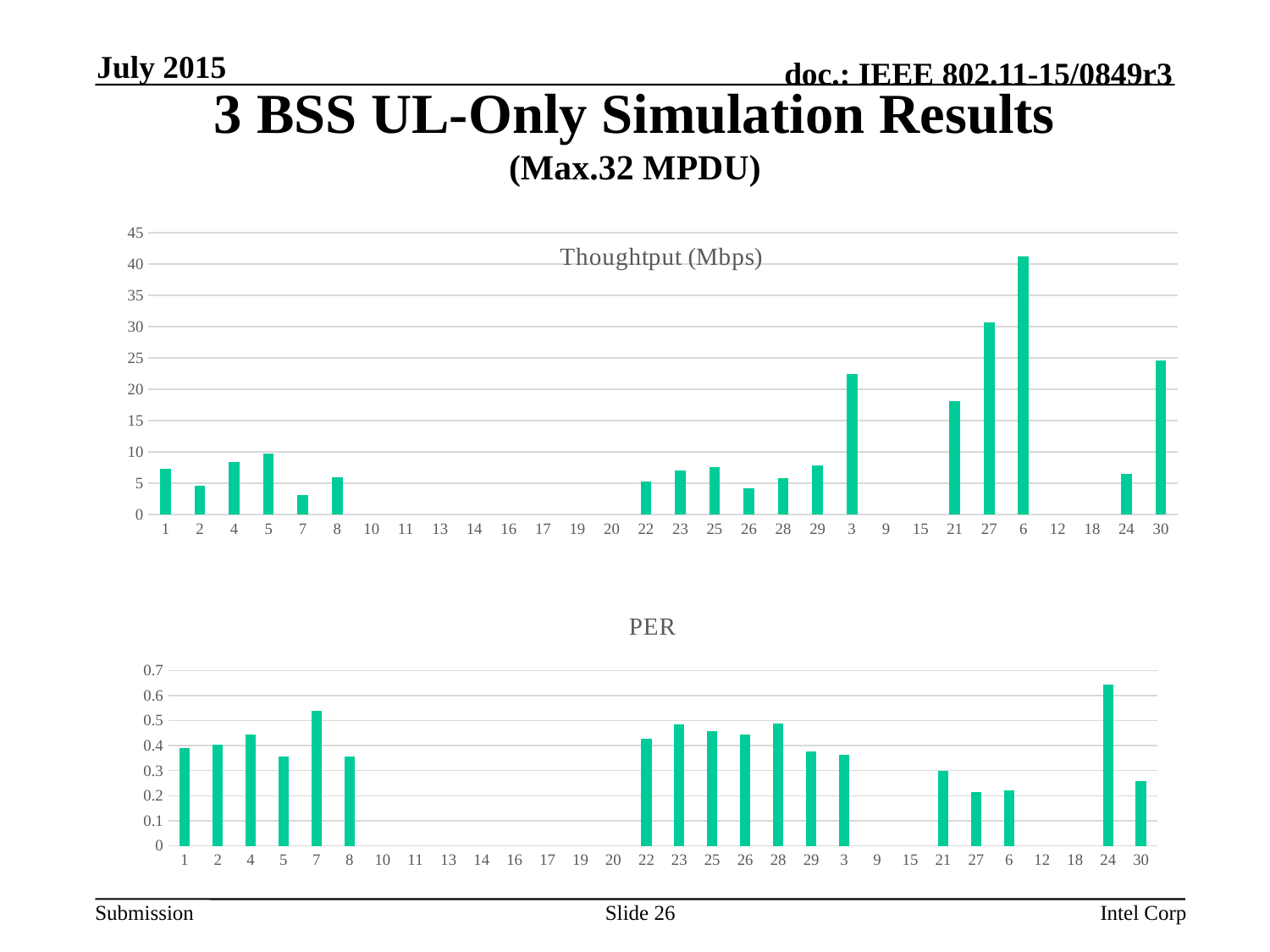
In the bottom chart (PER), which has the larger value, category 24 or category 7? 24 In the bottom chart (PER), is the value for category 7 greater or less than 0.5? greater What kind of chart is the top chart titled "Thoughtput (Mbps)"? bar chart In the top chart (Thoughtput (Mbps)), which category has the highest value? 6 In the bottom chart (PER), is the value for category 24 greater or less than 0.6? greater In the top chart (Thoughtput (Mbps)), is the value for category 1 greater or less than 5? greater In the top chart (Thoughtput (Mbps)), which has the larger value, category 6 or category 27? 6 How many categories are shown on the x axis of the bottom chart (PER)? 30 In the bottom chart (PER), which category has the highest value? 24